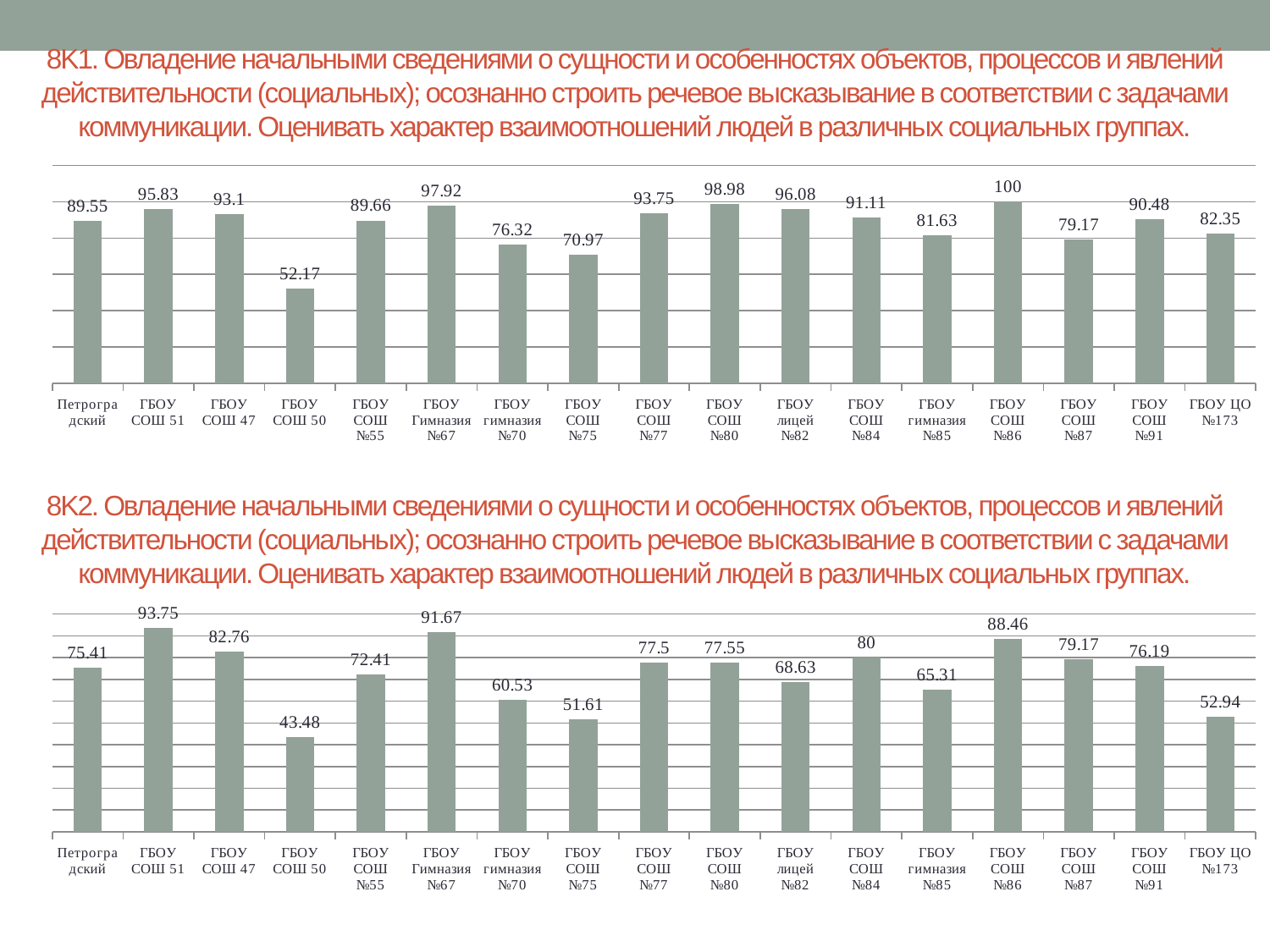
On the bottom chart (8К2), what is the value for ГБОУ Гимназия №67? 91.67 On the bottom chart (8К2), what is the difference between the values for ГБОУ СОШ №84 and ГБОУ ЦО №173? 27.06 On the bottom chart (8К2), which category has the highest value? ГБОУ СОШ 51 On the top chart (8К1), which category has the lowest value? ГБОУ СОШ 50 On the top chart (8К1), what is the value for ГБОУ СОШ 50? 52.17 On the top chart (8К1), which category has the highest value? ГБОУ СОШ №86 On the bottom chart (8К2), which category has the lowest value? ГБОУ СОШ 50 On the top chart (8К1), how many categories are plotted? 17 On the top chart (8К1), which is larger: the value for ГБОУ гимназия №70 or ГБОУ СОШ №75? ГБОУ гимназия №70 What type of chart is the bottom chart (8К2)? Bar chart On the bottom chart (8К2), which is larger: the value for Петроградский or ГБОУ СОШ №86? ГБОУ СОШ №86 On the top chart (8К1), what is the difference between the values for ГБОУ СОШ №80 and ГБОУ гимназия №85? 17.35